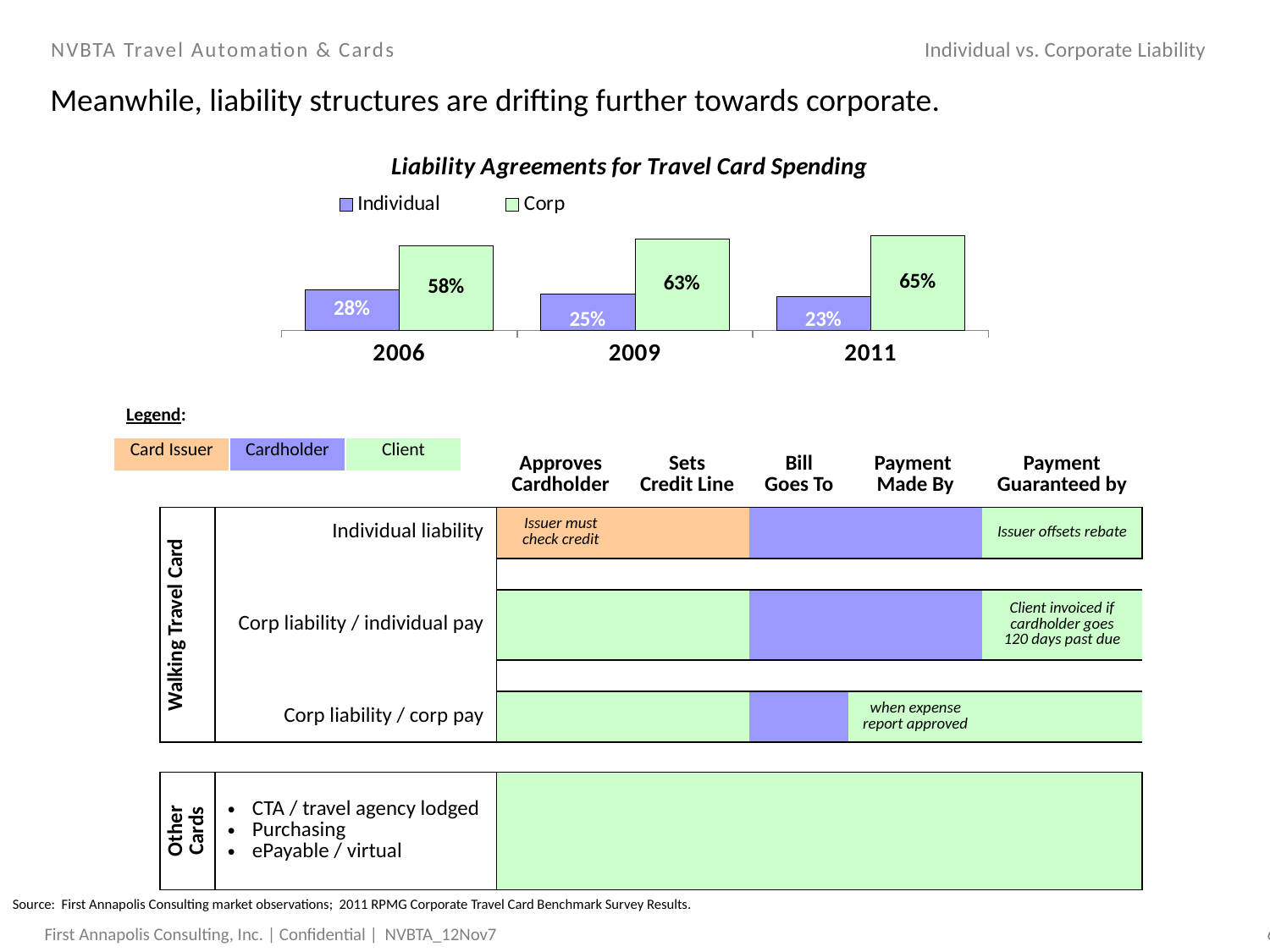
What is the Corp value for 2009? 63% Which year has the highest Corp value? 2011 What is the difference between the Corp and Individual values in 2009? 38% Which is larger in 2006, the Individual value or the Corp value? Corp Does the Individual series rise or fall from 2006 to 2011? Fall Which year has the lowest Individual value? 2011 What is the Individual value for 2006? 28% What is the Corp value for 2011? 65% What kind of chart is used to show Liability Agreements for Travel Card Spending? Bar chart How many series does the chart legend list? 2 How many years are shown on the x axis of the chart? 3 What is the Individual value for 2011? 23%